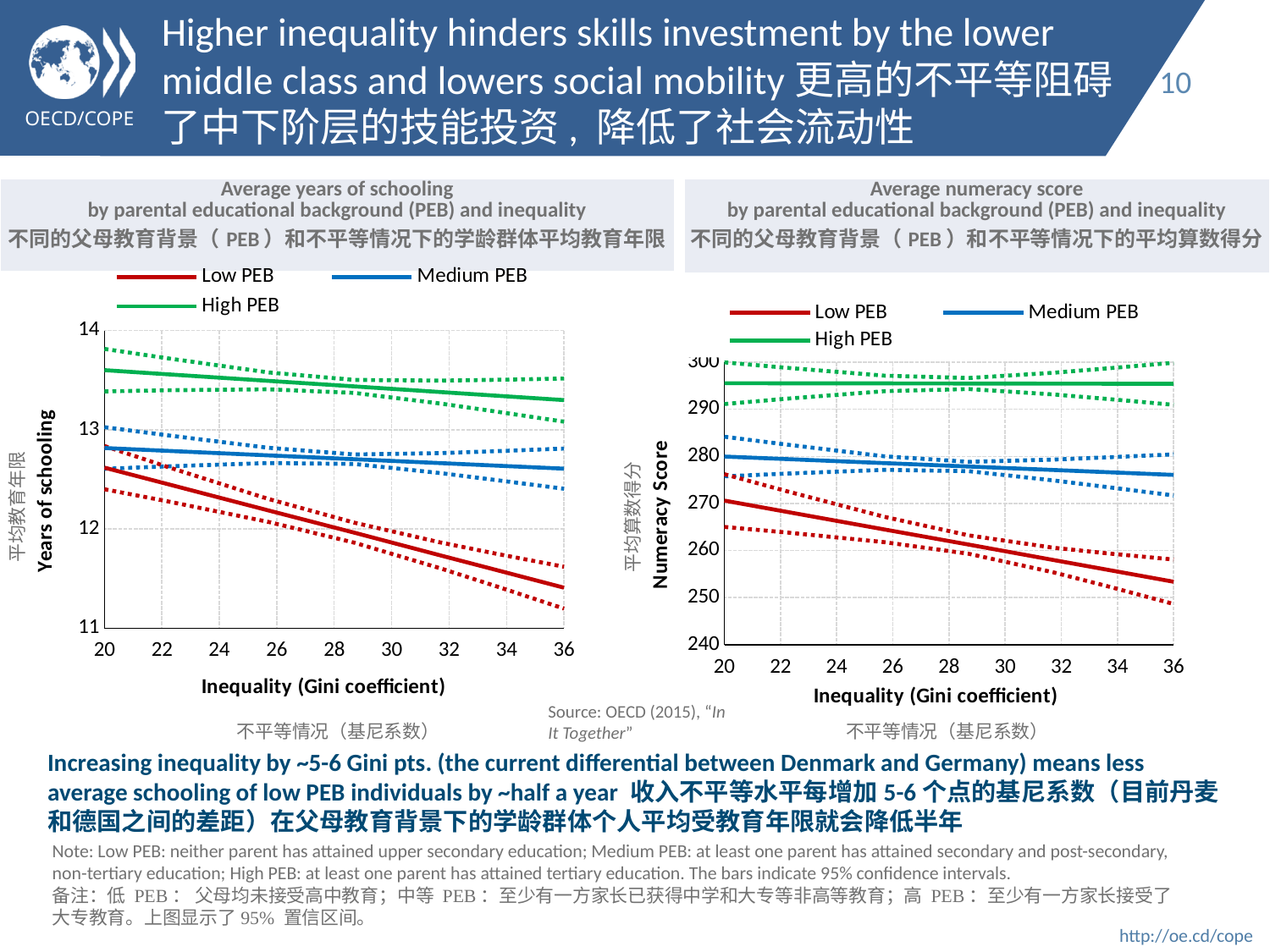
In the 'Average numeracy score' chart, which is larger at a Gini coefficient of 36: the Low PEB value or the Medium PEB value? Medium PEB What is the x-axis label of the 'Average numeracy score' chart? Inequality (Gini coefficient) In the 'Average years of schooling' chart, which PEB group has the highest years of schooling across the whole Gini range? High PEB In the 'Average numeracy score' chart, is the Low PEB value at a Gini coefficient of 20 greater or less than 260? greater In the 'Average years of schooling' chart, is the High PEB value at a Gini coefficient of 20 greater or less than 13? greater In the 'Average numeracy score' chart, do the values for Low PEB rise or fall as the Gini coefficient increases? fall How many series does the legend of the 'Average years of schooling' chart list? 3 In the 'Average numeracy score' chart, is the High PEB value at a Gini coefficient of 36 greater or less than 290? greater What kind of chart is the 'Average years of schooling' chart on the left? line chart In the 'Average numeracy score' chart, which PEB group has the lowest numeracy score across the whole Gini range? Low PEB In the 'Average years of schooling' chart, do the values for Low PEB rise or fall as the Gini coefficient increases? fall